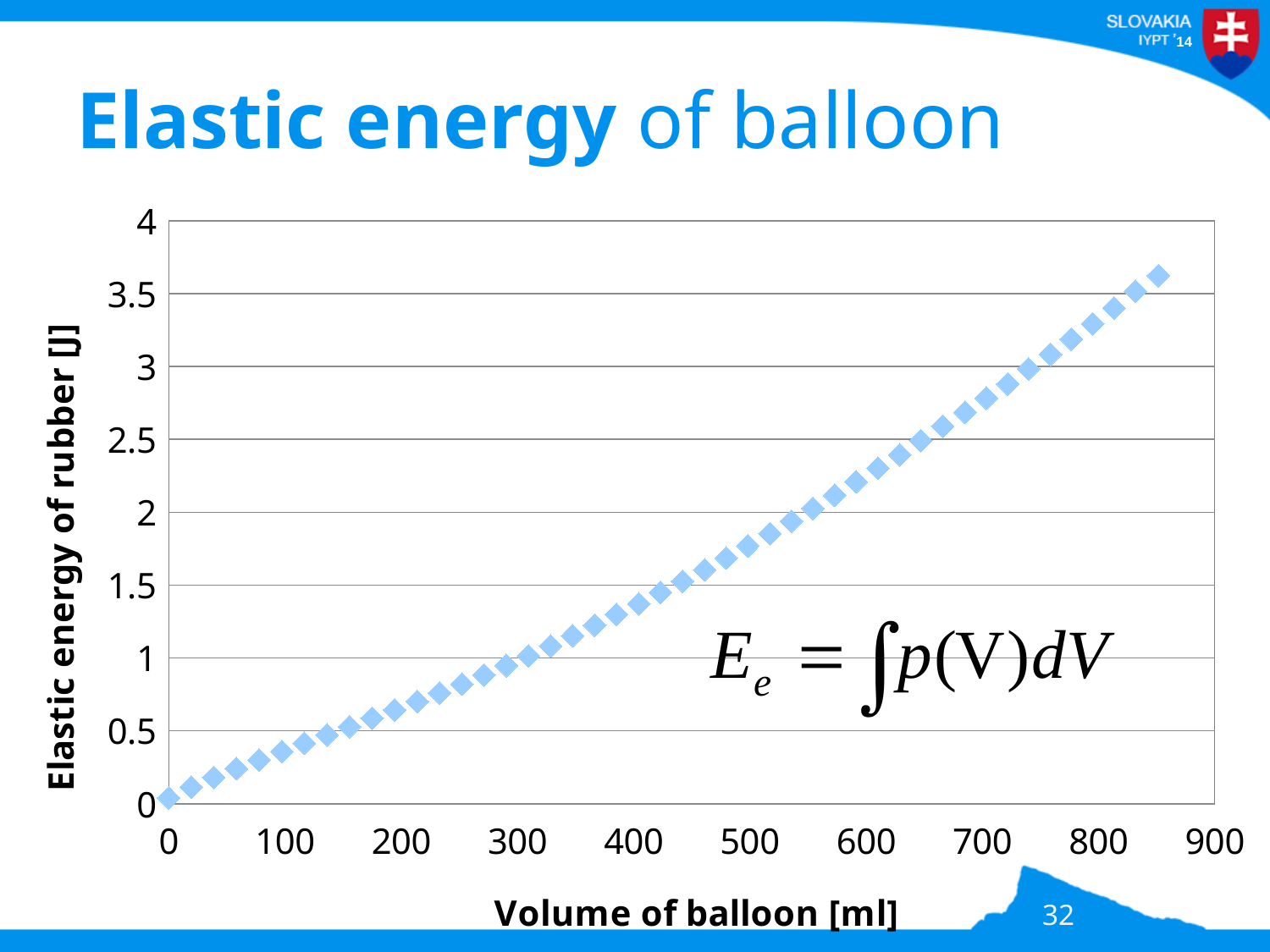
Which has the larger elastic energy: a volume of 300 ml or a volume of 700 ml? 700 ml What kind of chart is shown on the slide? scatter chart Is the elastic energy at a volume of 600 ml greater or less than 2 J? greater Is the elastic energy at a volume of 700 ml greater or less than 3.5 J? less Does the elastic energy of rubber rise or fall as the volume of balloon increases? rise Is the elastic energy at a volume of 400 ml greater or less than 1 J? greater What is the label of the vertical axis? Elastic energy of rubber [J] What is the label of the horizontal axis? Volume of balloon [ml] At which end of the volume axis is the elastic energy highest? the right end (largest volume)